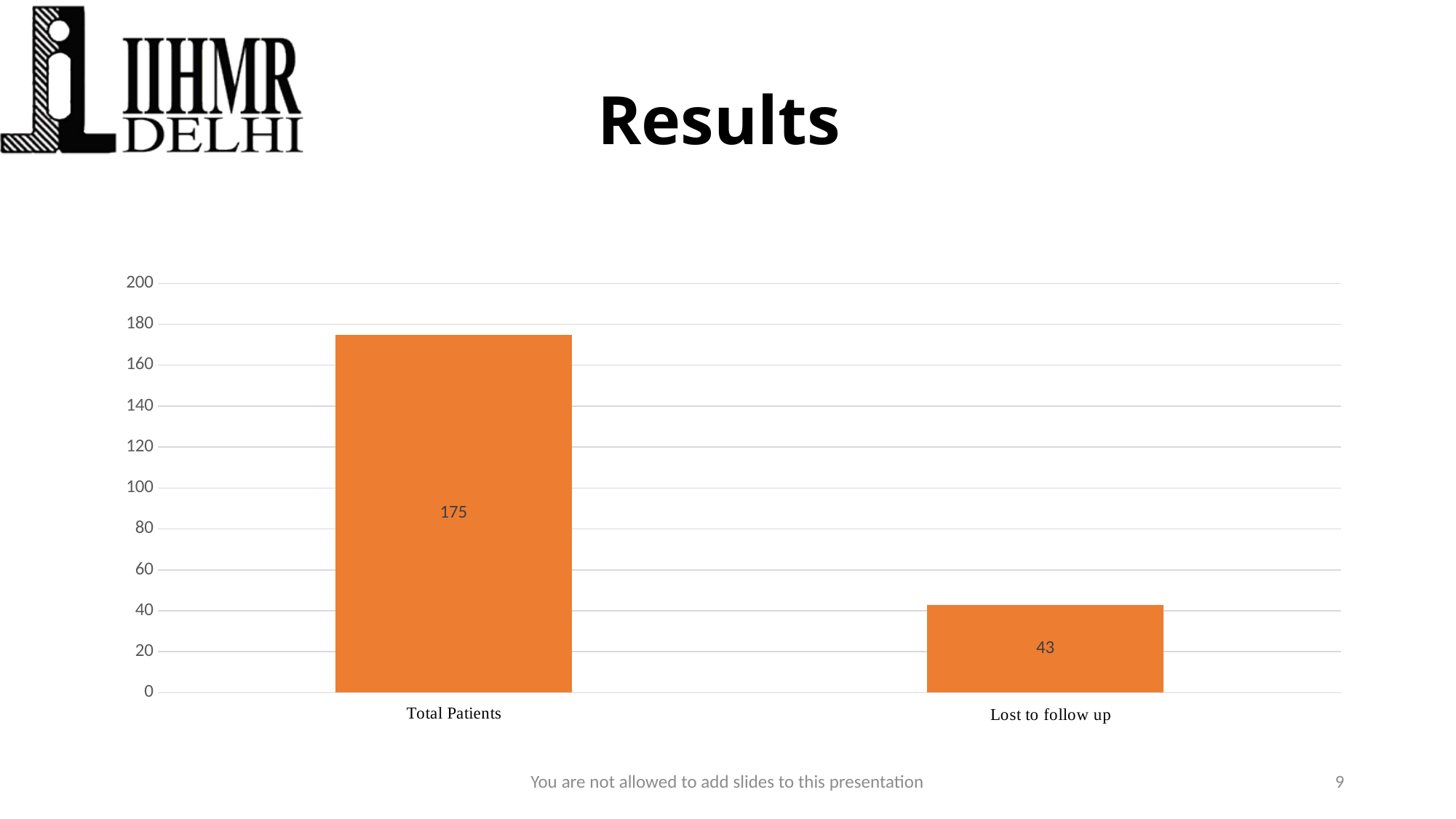
What is the difference between the values for Total Patients and Lost to follow up? 132 How many categories are shown on the chart? 2 What colour are the bars in the chart? orange What kind of chart is shown on the slide? bar chart What is the value for Total Patients? 175 Is the value for Lost to follow up greater or less than 60? less What is the value for Lost to follow up? 43 Is the value for Total Patients greater or less than 160? greater What is the maximum value shown on the vertical axis? 200 Which category has the highest value? Total Patients Which category has the lowest value? Lost to follow up Which is larger, the value for Total Patients or the value for Lost to follow up? Total Patients